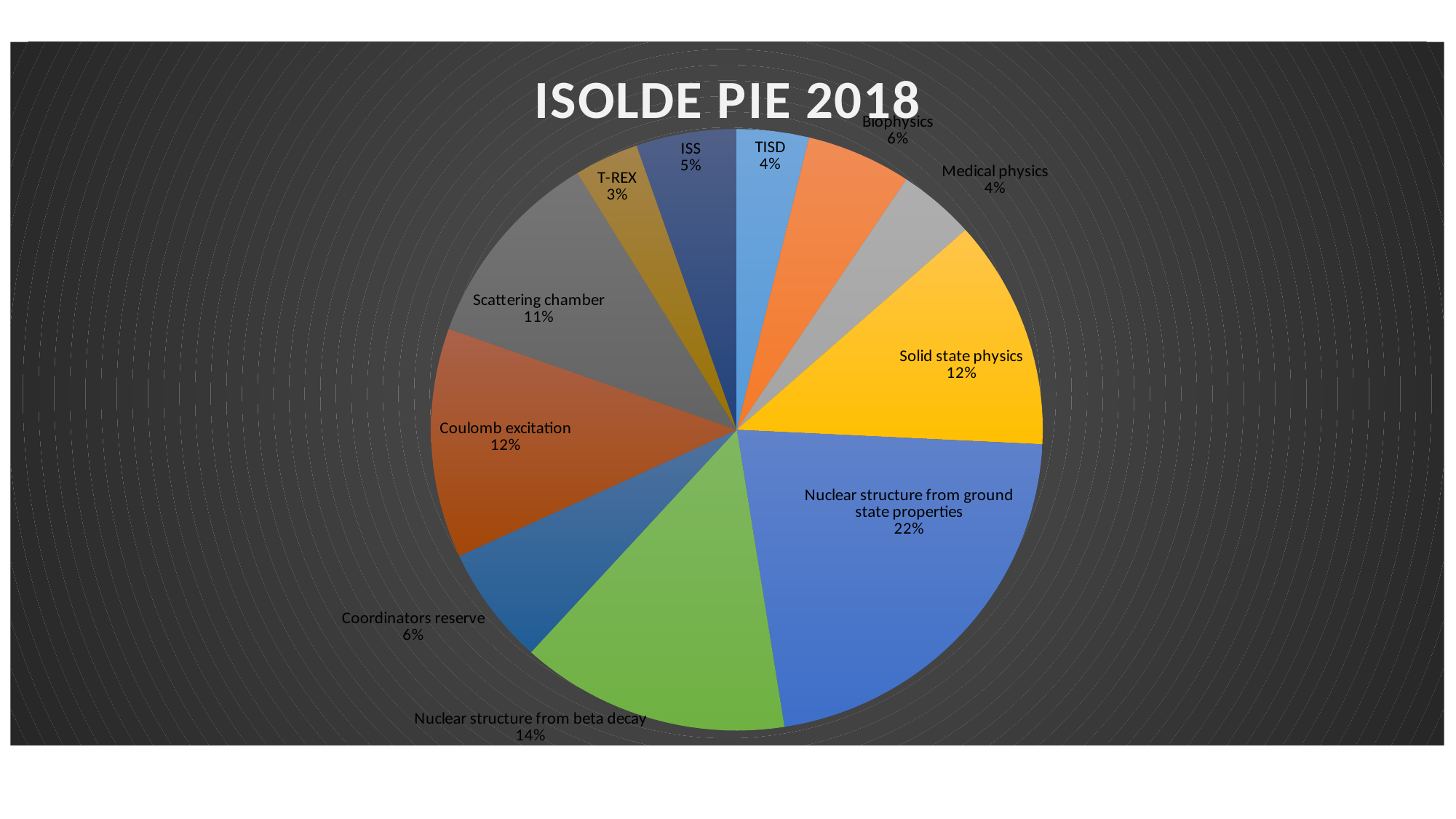
What is the difference in percentage points between Nuclear structure from beta decay and Coulomb excitation? 2 What percentage is shown for Medical physics? 4% What percentage is shown for Scattering chamber? 11% How many slices does the pie chart have? 11 What is the title of the chart? ISOLDE PIE 2018 What percentage is shown for Coordinators reserve? 6% What kind of chart is shown on the slide? pie chart What is the difference in percentage points between Nuclear structure from ground state properties and Solid state physics? 10 Which is larger, the slice for ISS or the slice for TISD? ISS Which category has the smallest slice of the pie? T-REX What share of the pie does Nuclear structure from ground state properties have? 22% Which category has the largest slice of the pie? Nuclear structure from ground state properties